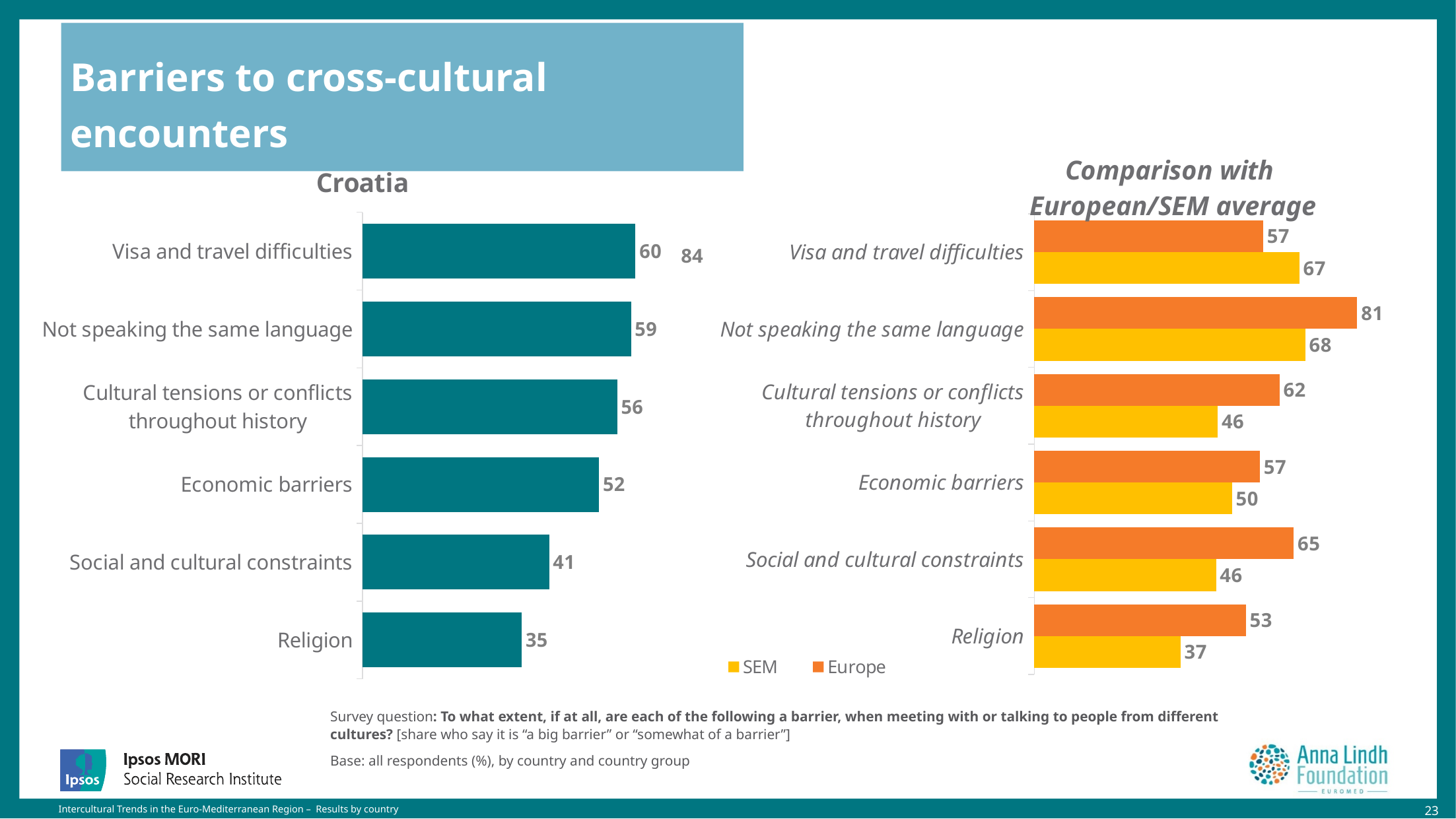
In the Comparison with European/SEM average chart, is the SEM value or the Europe value larger for Visa and travel difficulties? SEM In the Comparison with European/SEM average chart, which colour represents the SEM series? Yellow In the Comparison with European/SEM average chart, what is the Europe value for Not speaking the same language? 81 In the Comparison with European/SEM average chart, what is the difference between the Europe and SEM values for Social and cultural constraints? 19 In the Croatia chart, what is the value for Economic barriers? 52 In the Croatia chart, what is the difference between Visa and travel difficulties and Religion? 25 How many series does the legend of the Comparison with European/SEM average chart list? 2 In the Comparison with European/SEM average chart, what is the SEM value for Religion? 37 In the Croatia chart, how many barriers are listed? 6 What kind of chart is the Croatia chart? Bar chart In the Croatia chart, which barrier has the lowest value? Religion In the Comparison with European/SEM average chart, which barrier has the highest Europe value? Not speaking the same language